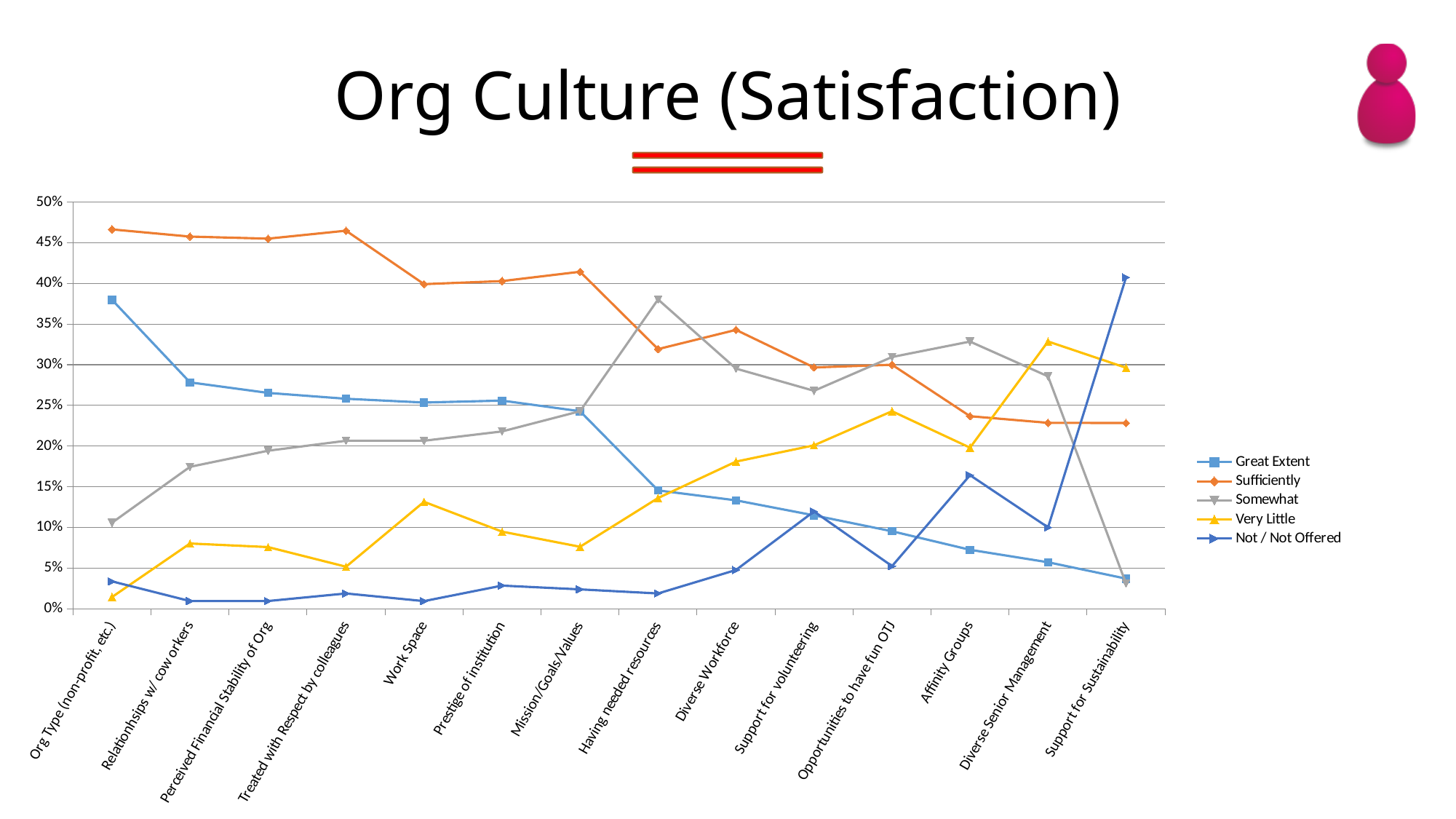
At Diverse Senior Management, which is larger: Very Little or Somewhat? Very Little For which category is the Great Extent series lowest? Support for Sustainability What kind of chart is shown on the slide? line chart Is the Sufficiently value for Org Type (non-profit, etc.) greater or less than 40%? greater Does the Great Extent series generally rise or fall from left to right along the x axis? fall How many categories are plotted along the x axis? 14 How many series does the legend list? 5 For which category is the Not / Not Offered series highest? Support for Sustainability For which category is the Great Extent series highest? Org Type (non-profit, etc.) Is the Great Extent value for Support for Sustainability greater or less than 5%? less Which series has the highest value for Org Type (non-profit, etc.)? Sufficiently Is the Somewhat value for Having needed resources greater or less than 35%? greater